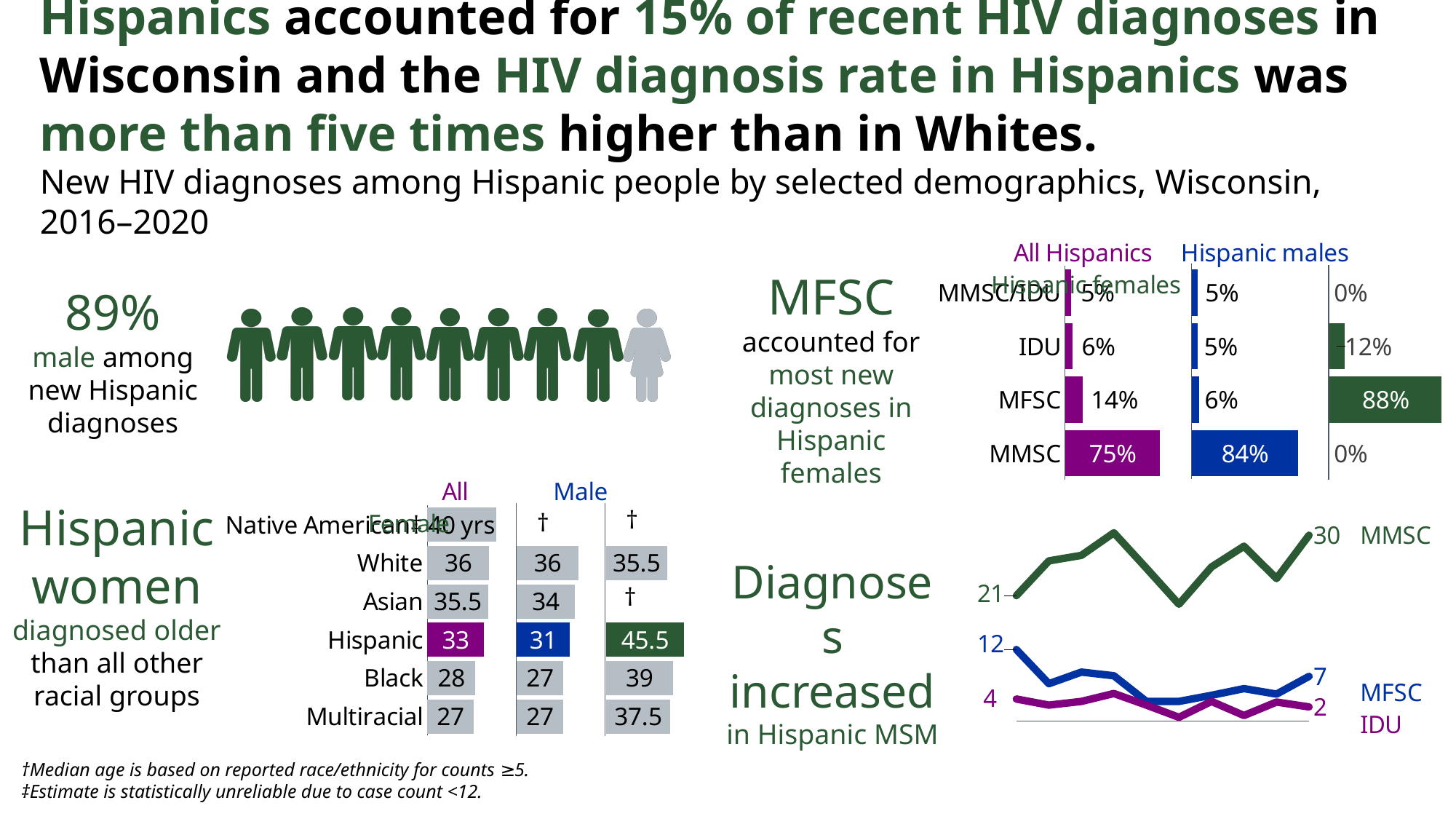
In the transmission category bar chart at the top right, how many percentage points higher is the MMSC share for Hispanic males than for All Hispanics? 9 percentage points In the transmission category bar chart at the top right, what percentage of diagnoses among Hispanic females were MFSC? 88% In the transmission category bar chart at the top right, what percentage of diagnoses among Hispanic males were MMSC? 84% In the median age bar chart at the bottom left, which racial group has the lowest median age in the All column? Multiracial In the line chart at the bottom right, does the MMSC line rise or fall from its first point to its last point? rises What kind of chart is shown at the bottom right of the slide showing MMSC, MFSC and IDU over time? line chart In the transmission category bar chart at the top right, what percentage of diagnoses among All Hispanics were MMSC? 75% In the median age bar chart at the bottom left, what is the median age for Hispanics in the All column? 33 In the median age bar chart at the bottom left, which is larger in the Female column: Black or Multiracial? Black In the median age bar chart at the bottom left, what is the difference between the Hispanic female median age and the Hispanic male median age? 14.5 In the median age bar chart at the bottom left, what is the median age for Hispanic females? 45.5 In the transmission category bar chart at the top right, which category accounts for the largest share of diagnoses among All Hispanics? MMSC